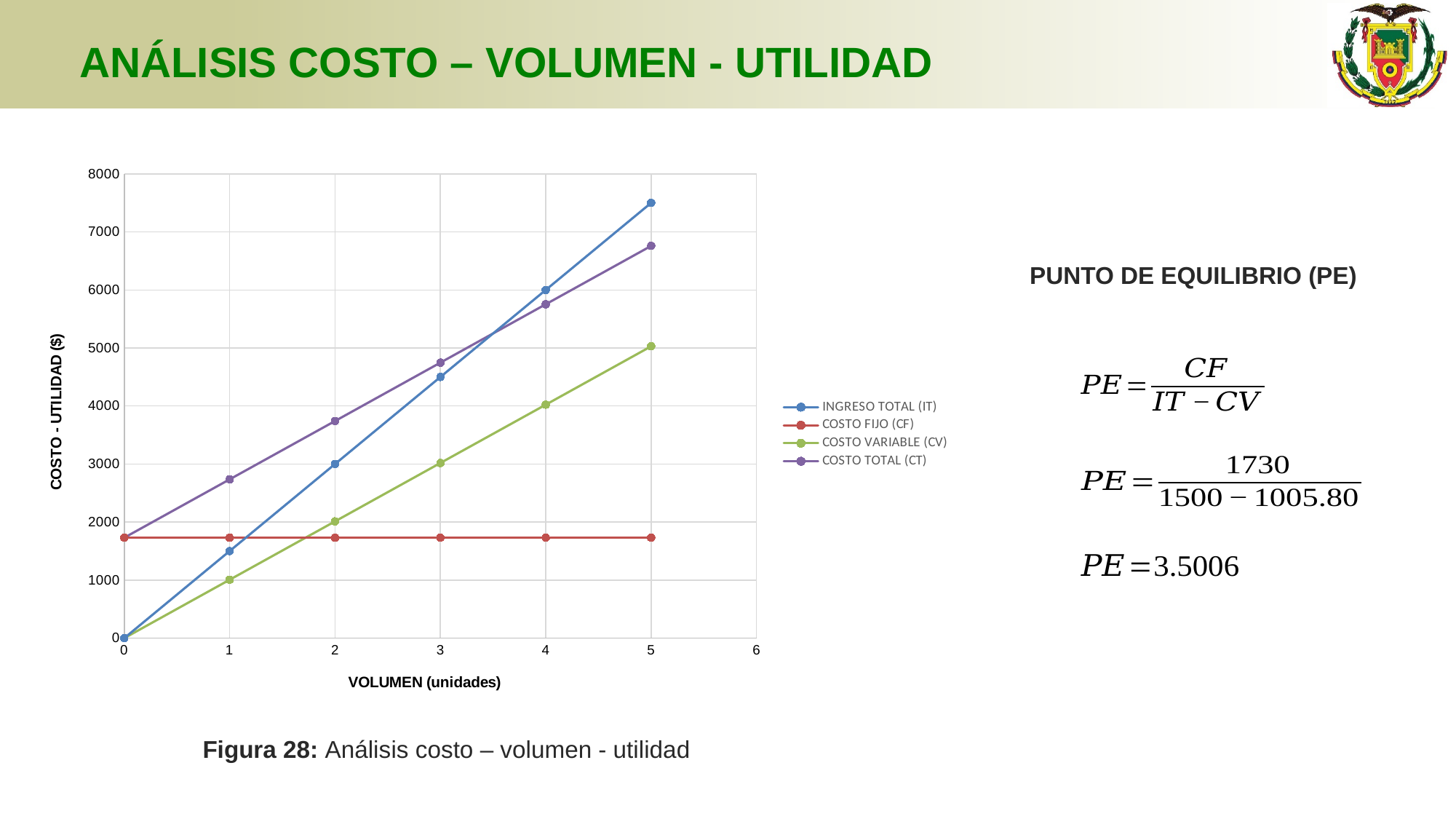
Which series has the lowest value at a volume of 5 units? COSTO FIJO (CF) What is the value of INGRESO TOTAL (IT) at a volume of 4 units? 6000 Which series has the highest value at a volume of 5 units? INGRESO TOTAL (IT) What is the value of INGRESO TOTAL (IT) at a volume of 2 units? 3000 At a volume of 2 units, which is larger: COSTO TOTAL (CT) or INGRESO TOTAL (IT)? COSTO TOTAL (CT) Does the COSTO FIJO (CF) series rise, fall, or stay flat as volume increases? stays flat What kind of chart is shown on the slide? line chart How many series does the chart legend list? 4 Is the value of COSTO FIJO (CF) greater or less than 2000? less What is the value of COSTO VARIABLE (CV) at a volume of 0 units? 0 How many data points are plotted for the INGRESO TOTAL (IT) series? 6 Is the value of COSTO TOTAL (CT) at a volume of 5 units greater or less than 7000? less